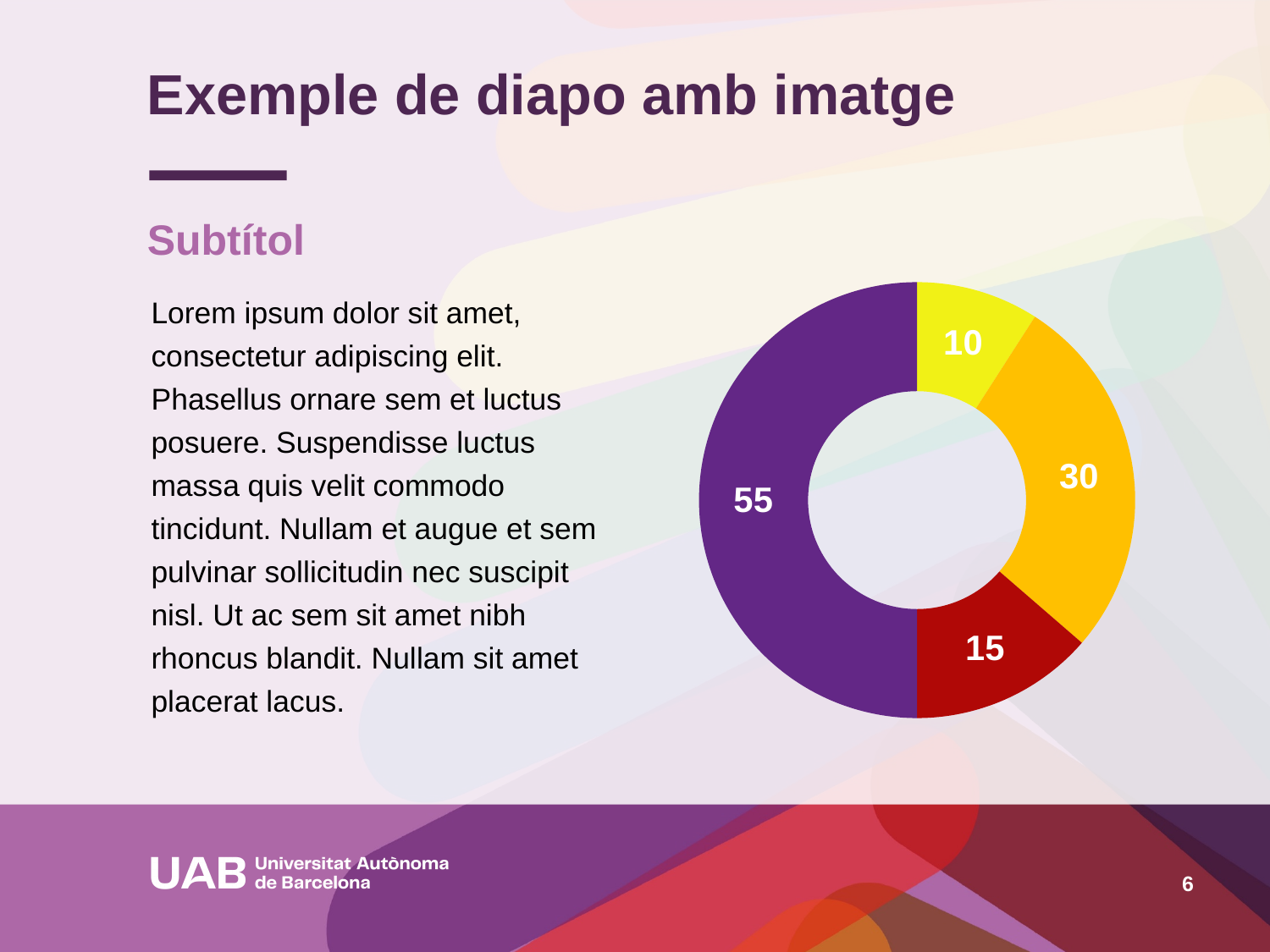
What is the difference between the purple slice and the orange slice in the doughnut chart? 25 Which slice of the doughnut chart has the largest value? The purple slice (55) What is the value of the purple slice in the doughnut chart? 55 How many slices does the doughnut chart have? 4 What is the value of the red slice in the doughnut chart? 15 Which slice of the doughnut chart has the smallest value? The yellow slice (10) What is the value of the orange slice in the doughnut chart? 30 What share of the doughnut chart's total does the purple slice (55) represent? 50% What is the total of all the slice values in the doughnut chart? 110 What kind of chart is shown on the slide? Doughnut chart What is the value of the yellow slice in the doughnut chart? 10 Which is larger in the doughnut chart, the red slice or the orange slice? The orange slice (30)